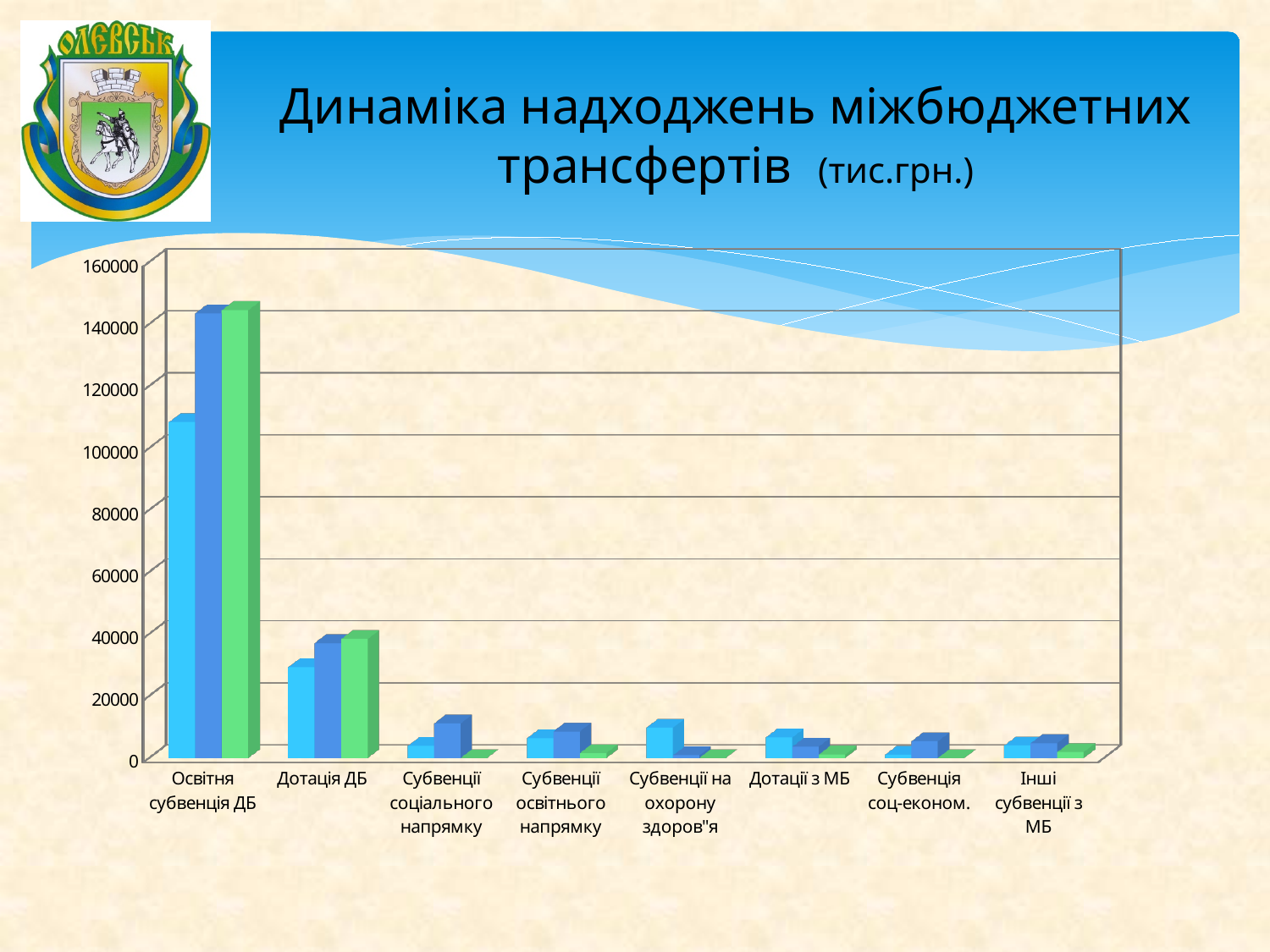
How many categories are shown along the x axis of the chart? 8 What kind of chart is shown on the slide? bar chart Is the value of the dark blue bar for Субвенції соціального напрямку greater or less than 20000? less Is the value of the green bar for Дотація ДБ greater or less than 20000? greater Do the values generally rise or fall moving from left to right along the x axis? fall Is the value of the light blue bar for Дотація ДБ greater or less than 40000? less What is the title of the chart on the slide? Динаміка надходжень міжбюджетних трансфертів (тис.грн.) Which category has larger values, Освітня субвенція ДБ or Дотація ДБ? Освітня субвенція ДБ Which category has the highest values in the chart? Освітня субвенція ДБ What unit is stated in the chart title for the values? тис.грн.